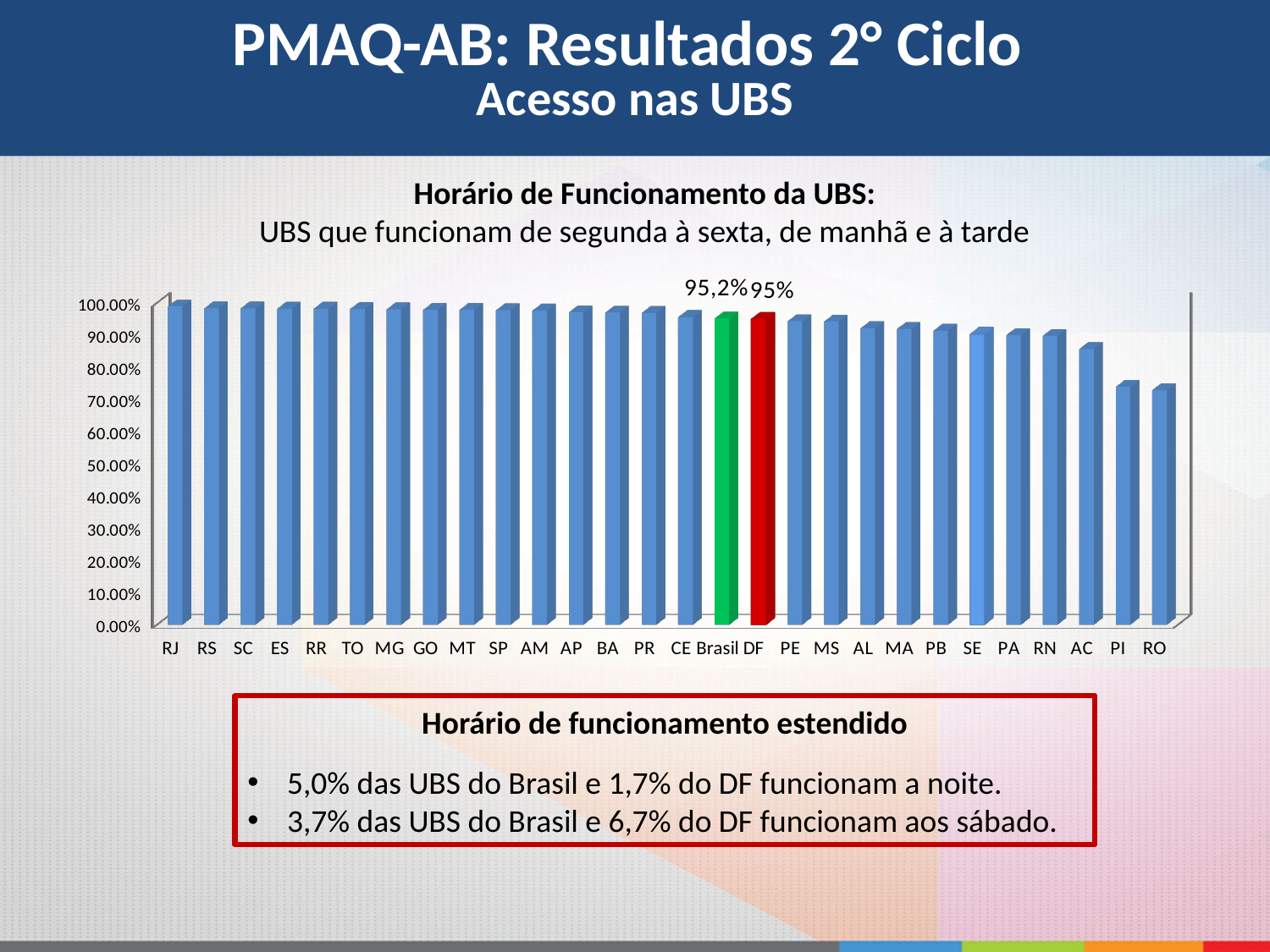
Which state has the highest bar in the chart? RJ Which state has the lowest bar in the chart? RO What value is shown for Brasil in the chart? 95,2% What is the difference between the Brasil value and the DF value? 0,2% What value is shown for DF in the chart? 95% Is the value for PI greater or less than 80.00%? less Is the value for AC greater or less than 80.00%? greater Do the bar values generally rise or fall from left to right along the x axis? Fall What kind of chart is shown on the slide? Bar chart What colour is the bar for DF? Red Which is larger, the value for RJ or the value for RO? RJ How many categories (bars) are plotted in the chart? 28